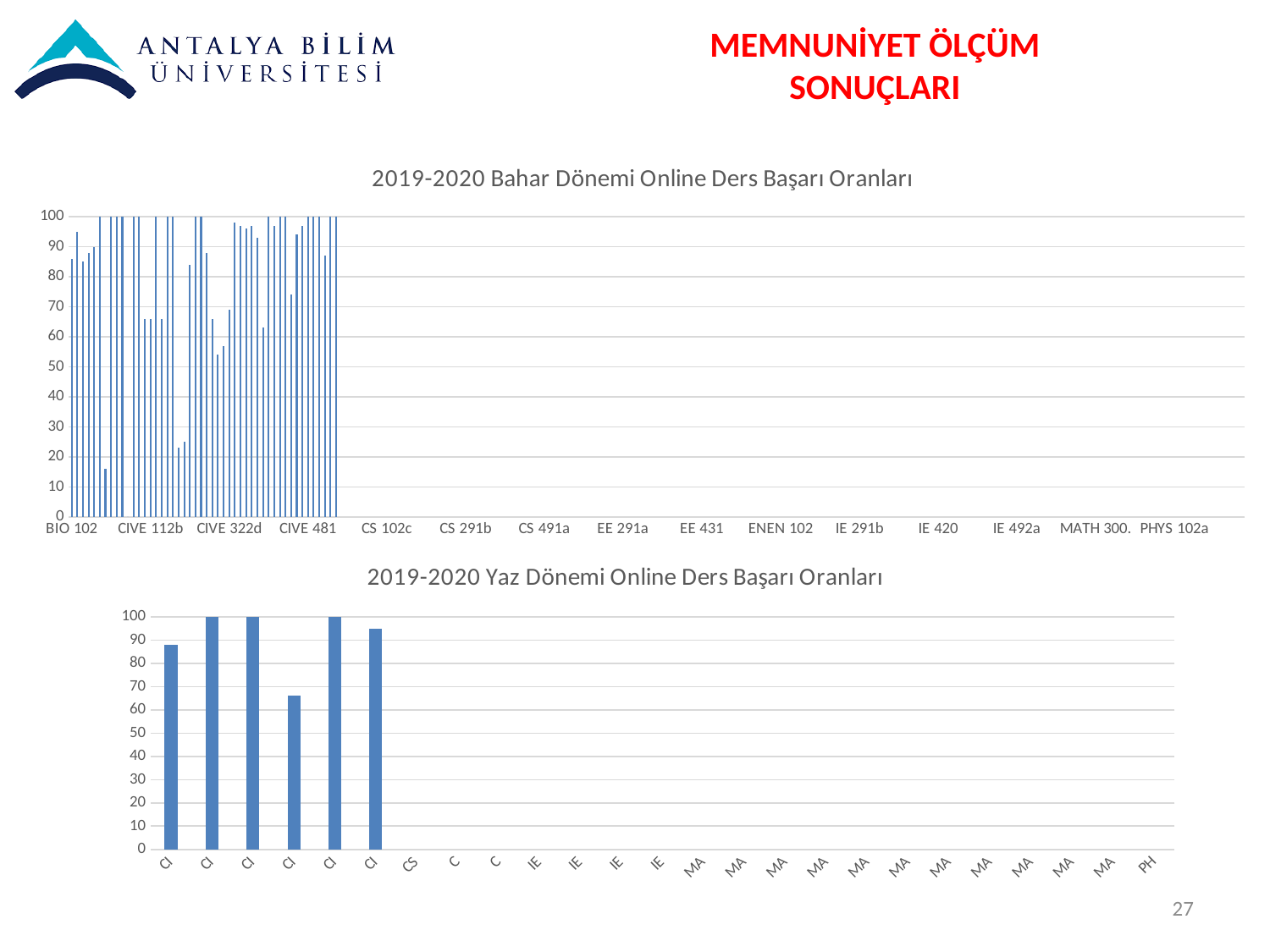
In the top chart (Bahar Dönemi), is the value of the first bar (BIO 102) greater or less than 70? greater What is the title of the bottom chart on the slide? 2019-2020 Yaz Dönemi Online Ders Başarı Oranları In the bottom chart (Yaz Dönemi), how many bars with a visible non-zero value are plotted? 6 What is the title of the top chart on the slide? 2019-2020 Bahar Dönemi Online Ders Başarı Oranları In the bottom chart (Yaz Dönemi), is the value of the first bar from the left greater or less than 80? greater In the bottom chart (Yaz Dönemi), how many bars reach the value 100? 3 In the bottom chart (Yaz Dönemi), which is lower: the first bar from the left or the fourth bar from the left? the fourth bar In the bottom chart (Yaz Dönemi), is the value of the fourth bar from the left greater or less than 70? less In the bottom chart (Yaz Dönemi), which bar has the lowest value? the fourth bar from the left In the bottom chart (Yaz Dönemi), what is the value of the second bar from the left? 100 What kind of chart is the top chart titled '2019-2020 Bahar Dönemi Online Ders Başarı Oranları'? bar chart What kind of chart is the bottom chart titled '2019-2020 Yaz Dönemi Online Ders Başarı Oranları'? bar chart